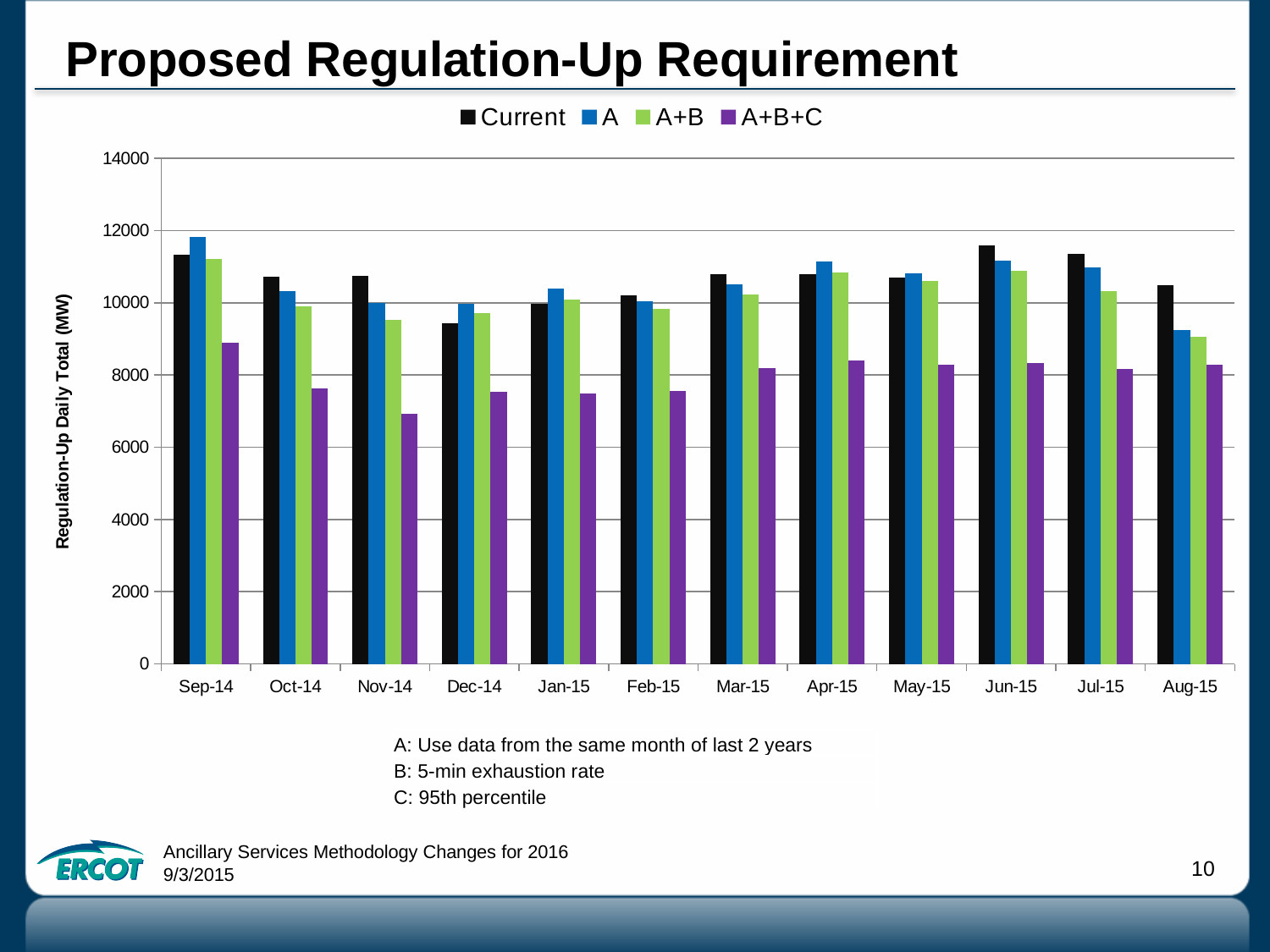
How many months are shown on the x axis? 12 Is the Current value for Sep-14 greater or less than 10000? greater How many series does the legend list? 4 In Aug-15, which is larger: the Current value or the A+B value? Current Which month has the lowest Current value? Dec-14 What kind of chart is shown on the slide? bar chart Is the value for series A in Aug-15 greater or less than 10000? less What is the label on the vertical axis? Regulation-Up Daily Total (MW) Is the A+B+C value for Nov-14 greater or less than 8000? less In Dec-14, which is larger: the Current value or the A value? A Which month has the lowest A+B+C value? Nov-14 Which month has the highest value for series A? Sep-14